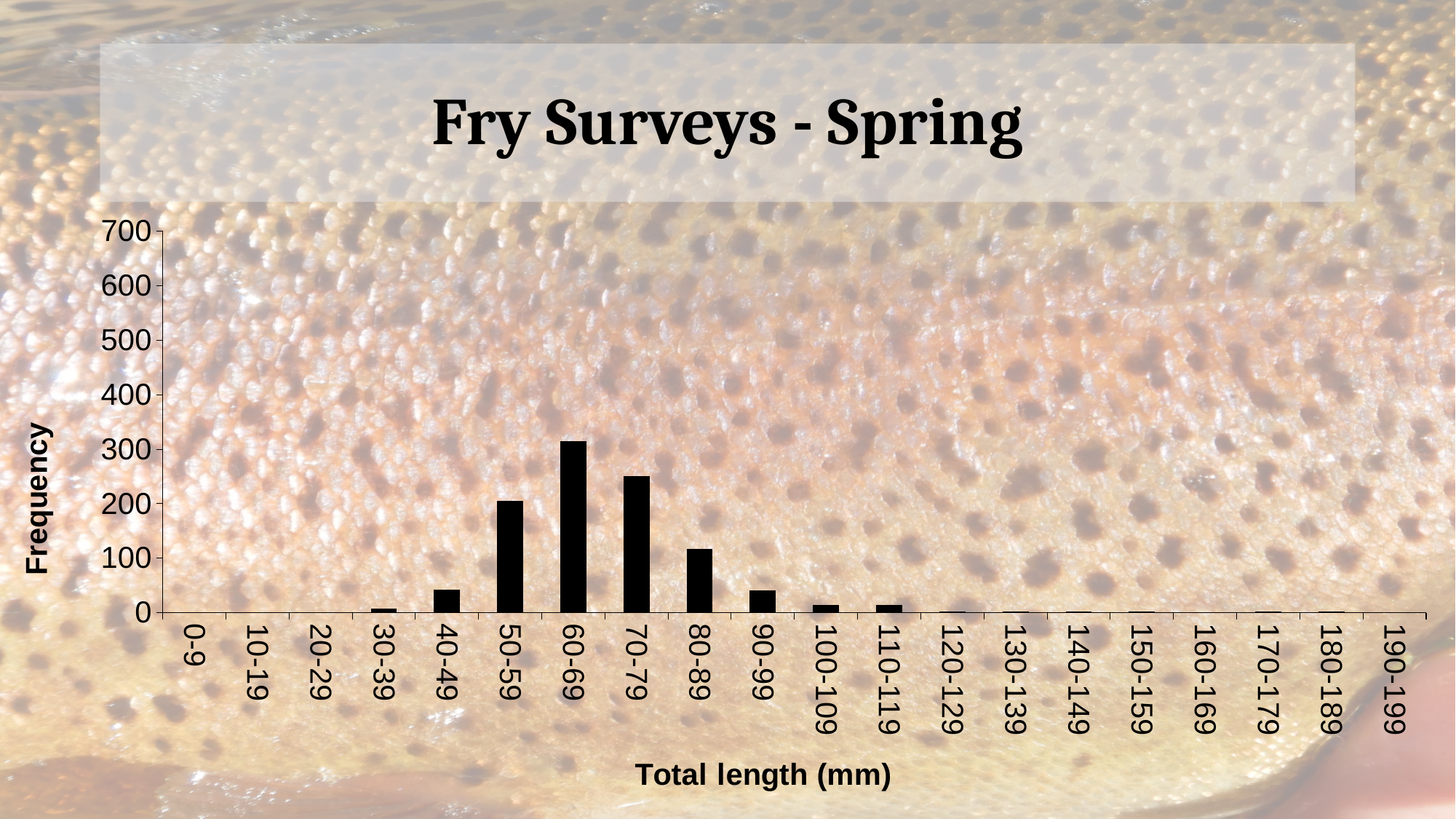
Which length category has the highest frequency? 60-69 Is the frequency for the 80-89 category greater or less than 200? less Do the frequencies rise or fall from the 60-69 category to the 90-99 category? fall How many length categories are shown on the x axis? 20 Which has the higher frequency, the 40-49 category or the 80-89 category? 80-89 Is the frequency for the 60-69 category greater or less than 300? greater What kind of chart is shown on the slide? bar chart Is the frequency for the 70-79 category greater or less than 300? less What is the label of the x axis? Total length (mm) Which has the higher frequency, the 50-59 category or the 70-79 category? 70-79 What is the title of the chart? Fry Surveys - Spring